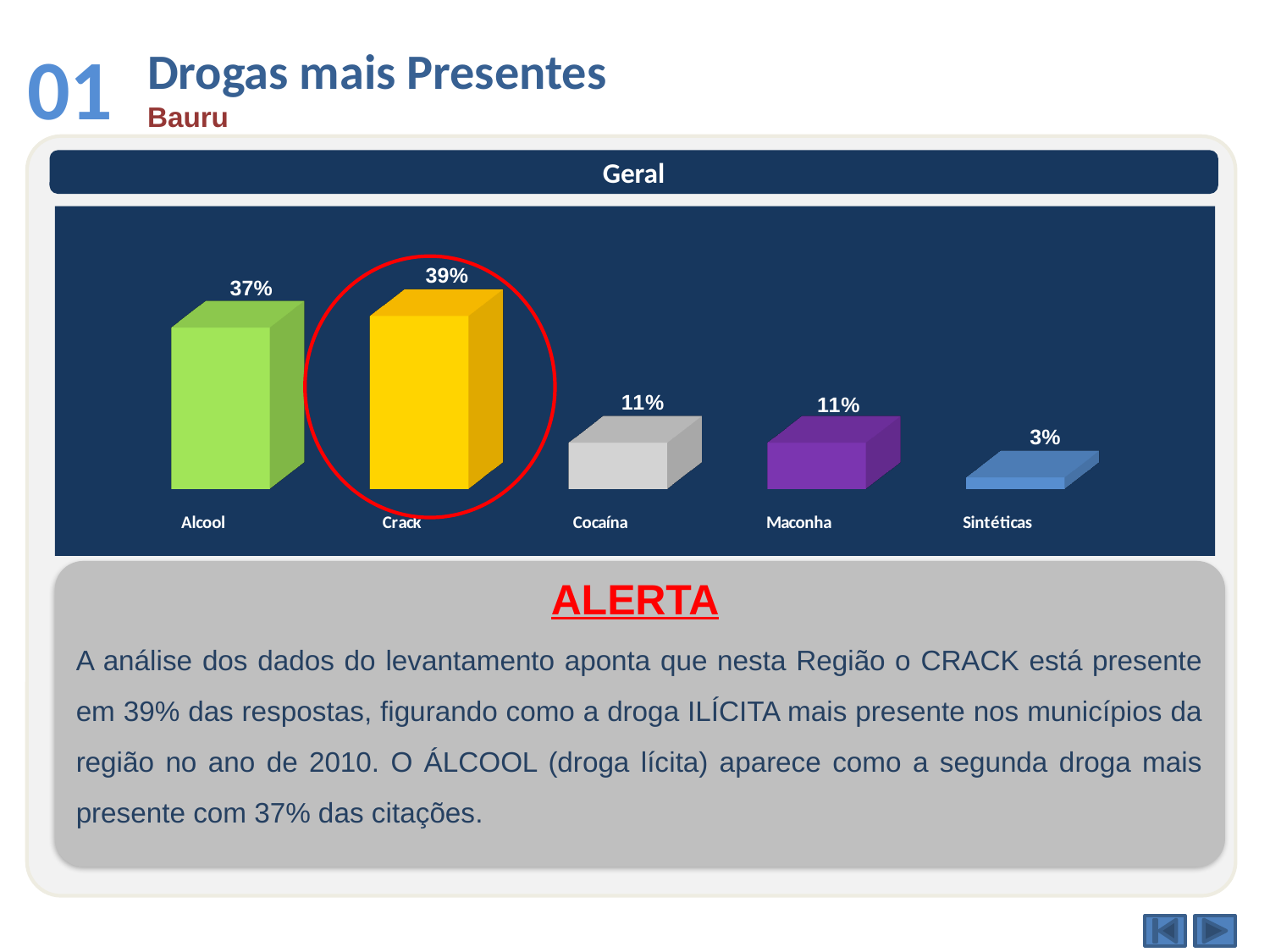
Which category has the lowest value? Sintéticas What is the difference between the values for Crack and Alcool? 2% What is the value for Sintéticas? 3% What is the difference between the values for Maconha and Sintéticas? 8% What kind of chart is shown on the slide? Bar chart Which category has the highest value? Crack Which is larger, the value for Alcool or the value for Cocaína? Alcool What is the value for Cocaína? 11% What is the value for Alcool? 37% What is the title shown above the chart? Geral What is the value for Crack? 39% How many categories are shown in the chart? 5